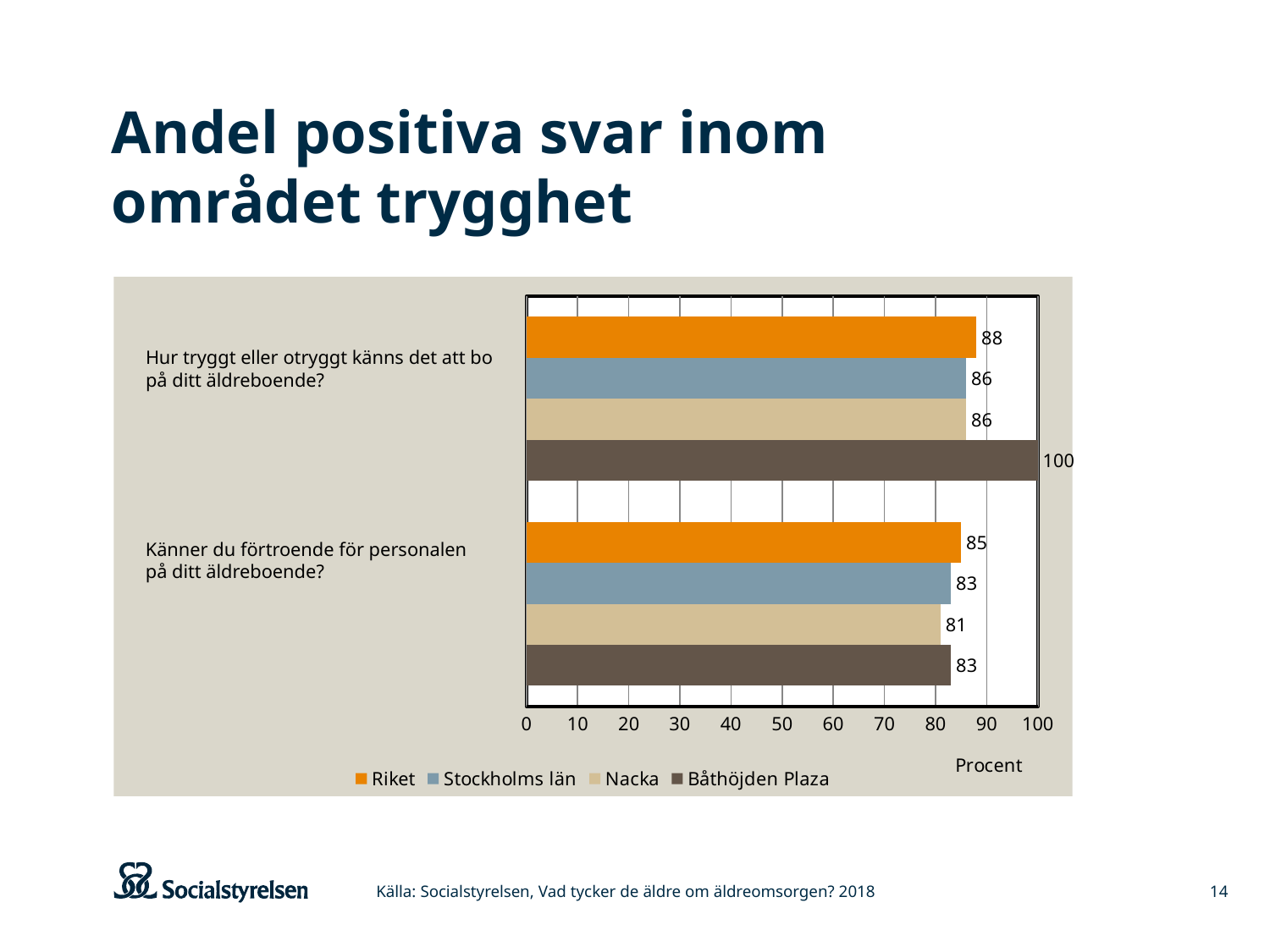
Which is larger: the Riket value or the Nacka value on the question "Känner du förtroende för personalen på ditt äldreboende?"? Riket How many questions (categories) are shown on the chart? 2 What is the label of the horizontal axis? Procent What kind of chart is shown on the slide? Bar chart Which series has the lowest value on the question "Känner du förtroende för personalen på ditt äldreboende?"? Nacka What is the value for Båthöjden Plaza on the question "Hur tryggt eller otryggt känns det att bo på ditt äldreboende?"? 100 What is the difference between the Båthöjden Plaza value and the Riket value on the question "Hur tryggt eller otryggt känns det att bo på ditt äldreboende?"? 12 Which series has the highest value on the question "Hur tryggt eller otryggt känns det att bo på ditt äldreboende?"? Båthöjden Plaza What is the value for Stockholms län on the question "Hur tryggt eller otryggt känns det att bo på ditt äldreboende?"? 86 What is the value for Nacka on the question "Känner du förtroende för personalen på ditt äldreboende?"? 81 How many series does the legend list? 4 What is the value for Riket on the question "Känner du förtroende för personalen på ditt äldreboende?"? 85